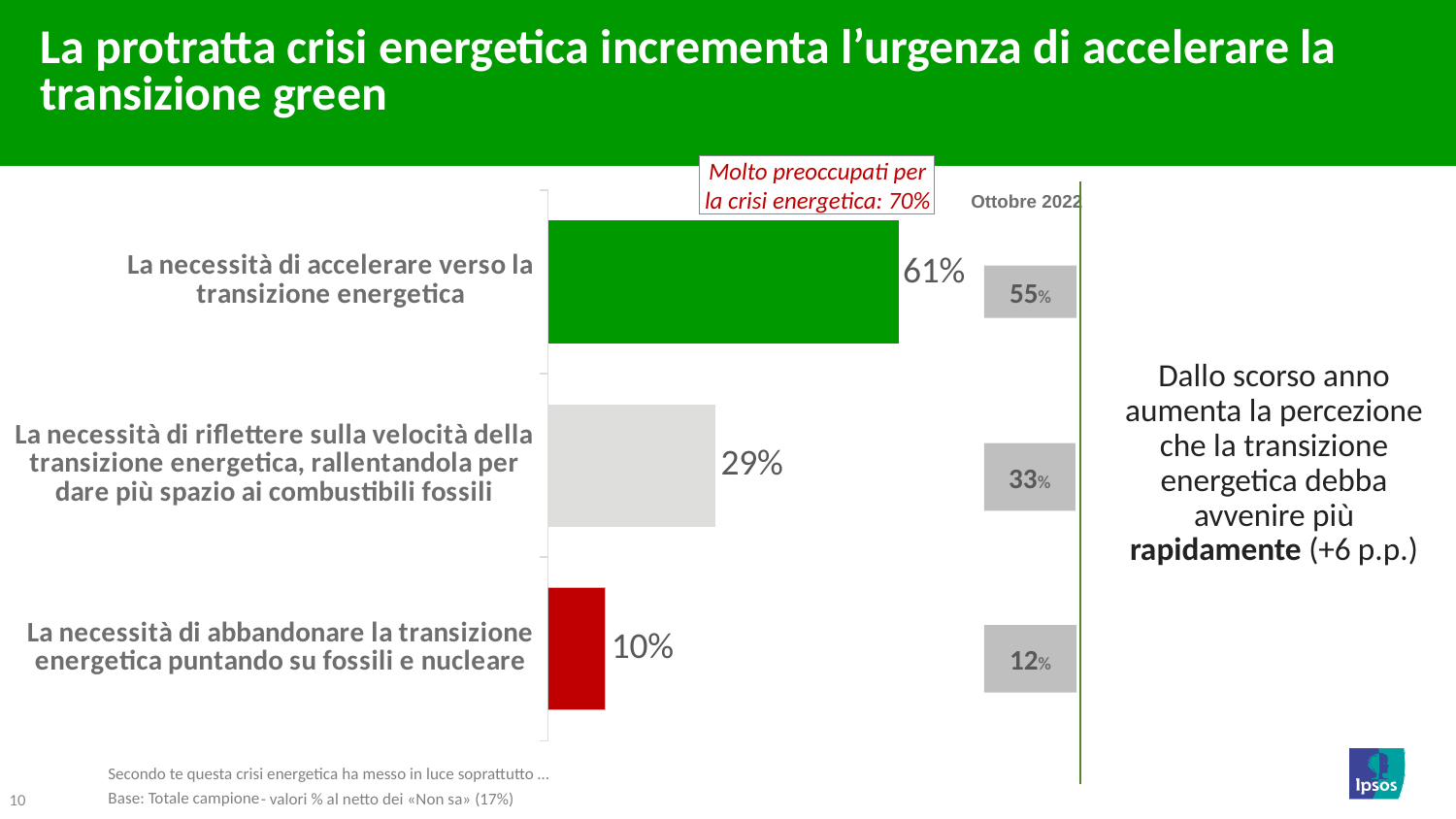
What colour is the bar for "La necessità di abbandonare la transizione energetica puntando su fossili e nucleare"? Red Which category has the highest value? La necessità di accelerare verso la transizione energetica How many categories are shown in the bar chart? 3 Which is larger: the value for slowing down the energy transition or the value for abandoning it? Slowing down the energy transition (29%) Which category has the lowest value? La necessità di abbandonare la transizione energetica puntando su fossili e nucleare What was the Ottobre 2022 value for "La necessità di abbandonare la transizione energetica puntando su fossili e nucleare"? 12% What is the value for "La necessità di accelerare verso la transizione energetica"? 61% What is the difference between the value for accelerating the energy transition (61%) and the value for slowing it down (29%)? 32 percentage points What is the value for "La necessità di riflettere sulla velocità della transizione energetica, rallentandola per dare più spazio ai combustibili fossili"? 29% What is the value for "La necessità di abbandonare la transizione energetica puntando su fossili e nucleare"? 10% What was the Ottobre 2022 value for "La necessità di accelerare verso la transizione energetica"? 55% What kind of chart is shown on the slide? Bar chart